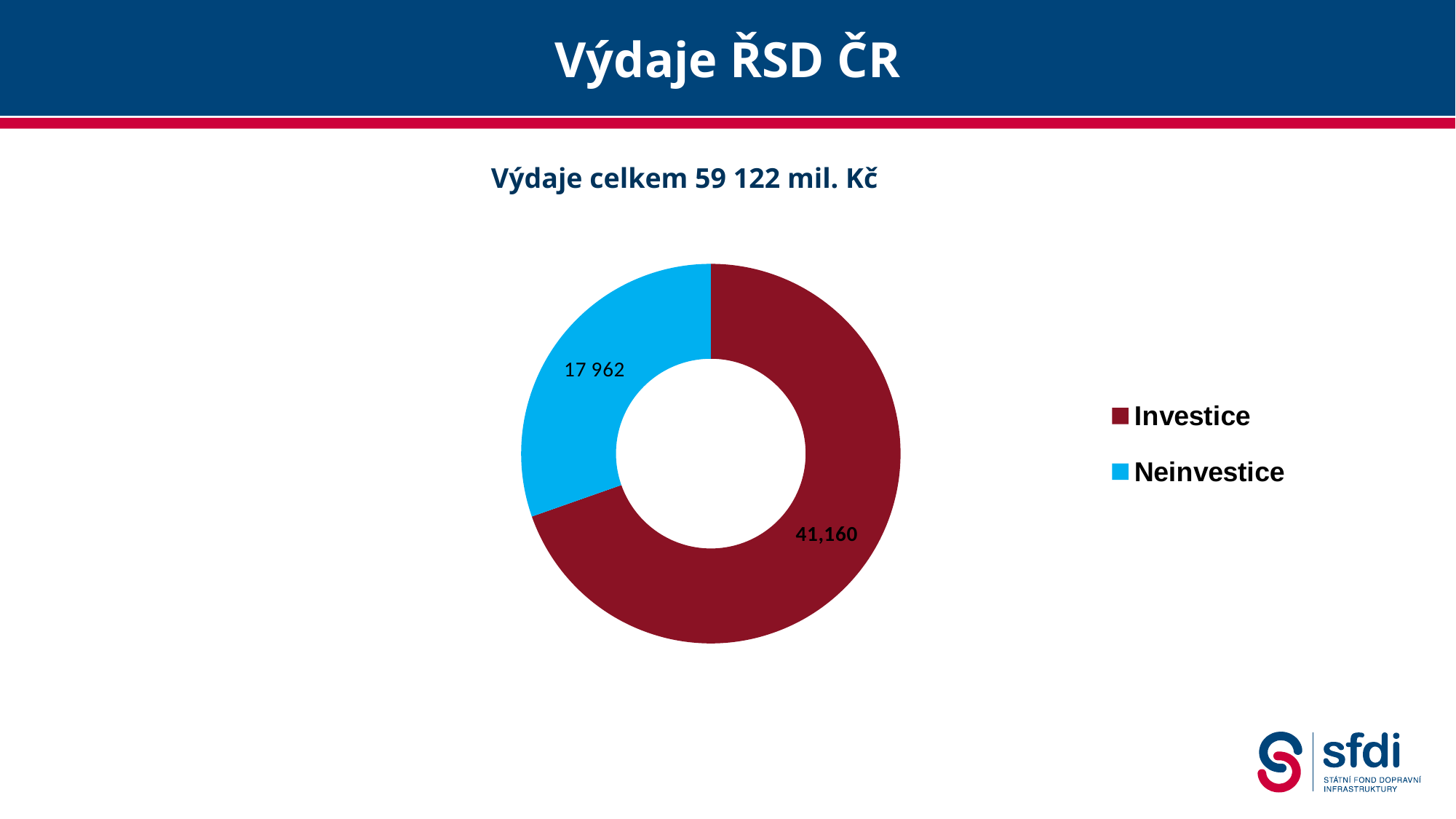
How many categories are shown in the chart? 2 What is the total of the two slices shown in the chart? 59 122 Which category has the larger slice, Investice or Neinvestice? Investice What is the value shown for the Investice slice? 41,160 What kind of chart is shown on the slide? Doughnut (pie) chart What is the value shown for the Neinvestice slice? 17 962 Which category has the largest slice in the chart? Investice What is the title shown above the chart? Výdaje celkem 59 122 mil. Kč What is the difference between the Investice value and the Neinvestice value? 23 198 Which category has the smallest slice in the chart? Neinvestice